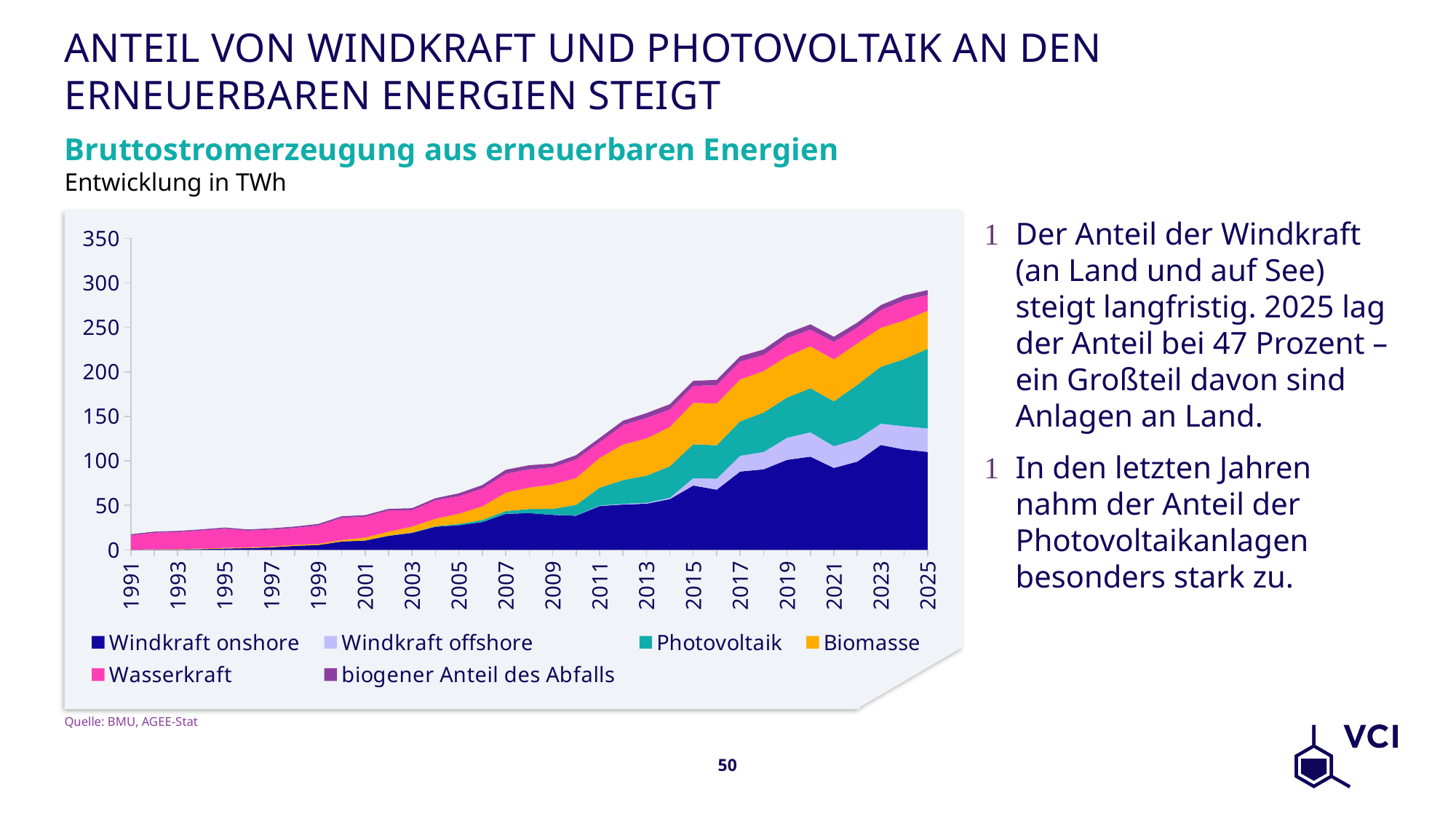
Does the total gross electricity generation from renewables rise or fall from 1991 to 2025? Rises Is the total value for 2015 greater or less than 150? greater Which series is plotted at the bottom of the stack? Windkraft onshore Is the total value for 2007 greater or less than 100? less Which year has the highest total value in the chart? 2025 How many series does the chart legend list? 6 In what unit are the values of the chart given? TWh How many year labels are shown on the x axis of the chart? 18 What kind of chart is shown on the slide? Stacked area chart Is the total value for 2025 greater or less than 250? greater Which year has the lowest total value in the chart? 1991